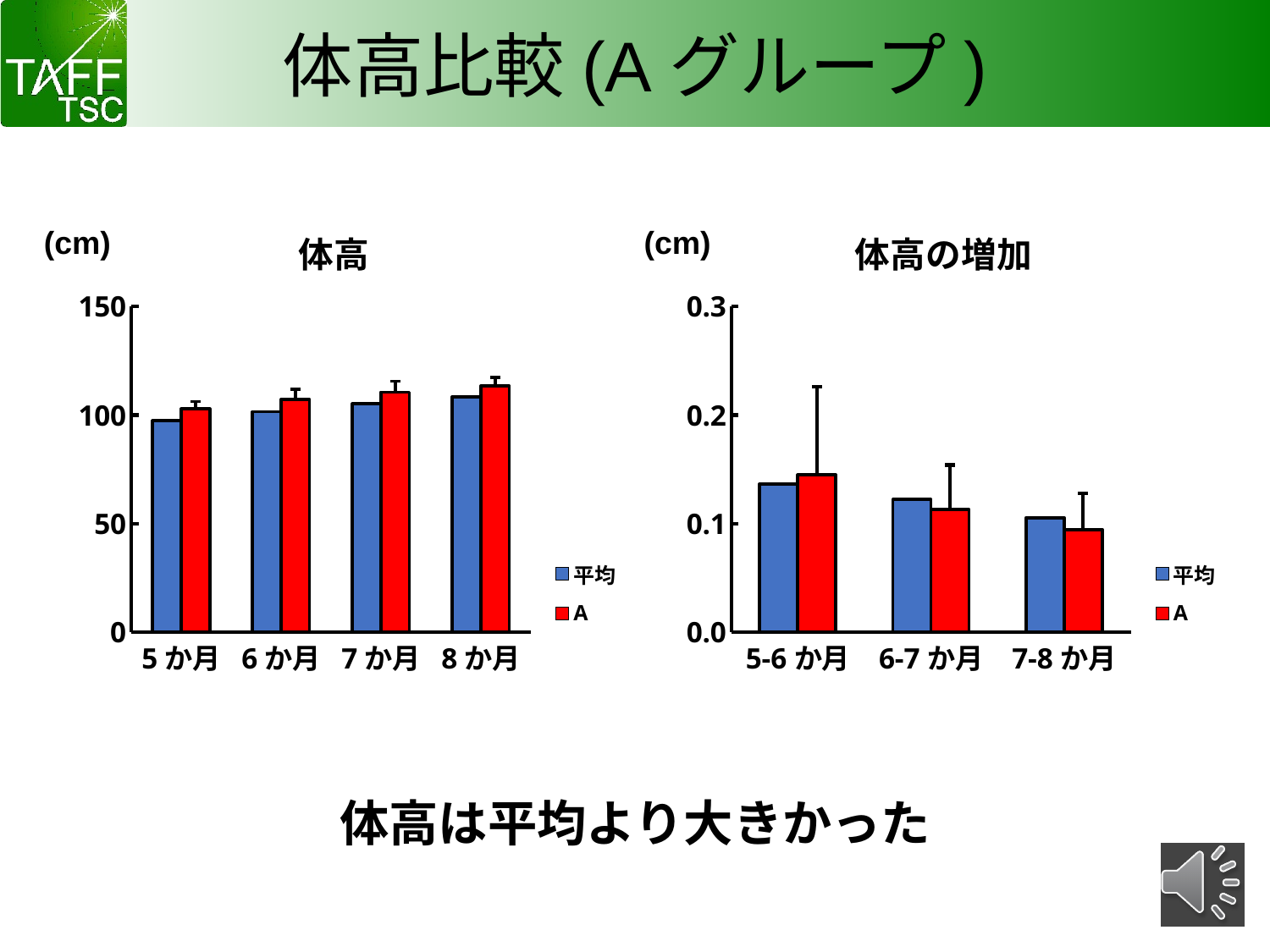
In the left chart (体高), is the value for A at 8 か月 greater or less than 100? greater In the left chart (体高), which category has the highest value for A? 8 か月 How many categories are shown on the x axis of the left chart (体高)? 4 In the left chart (体高), do the values for 平均 rise or fall from 5 か月 to 8 か月? rise In the right chart (体高の増加), is the value for A at 5-6 か月 greater or less than 0.2? less What kind of chart is the left chart titled 体高? bar chart How many categories are shown on the x axis of the right chart (体高の増加)? 3 How many series does the legend of the right chart (体高の増加) list? 2 What unit is shown above the y axis of the left chart (体高)? (cm) In the right chart (体高の増加), is the value for 平均 at 5-6 か月 greater or less than 0.1? greater In the right chart (体高の増加), which category has the highest value for 平均? 5-6 か月